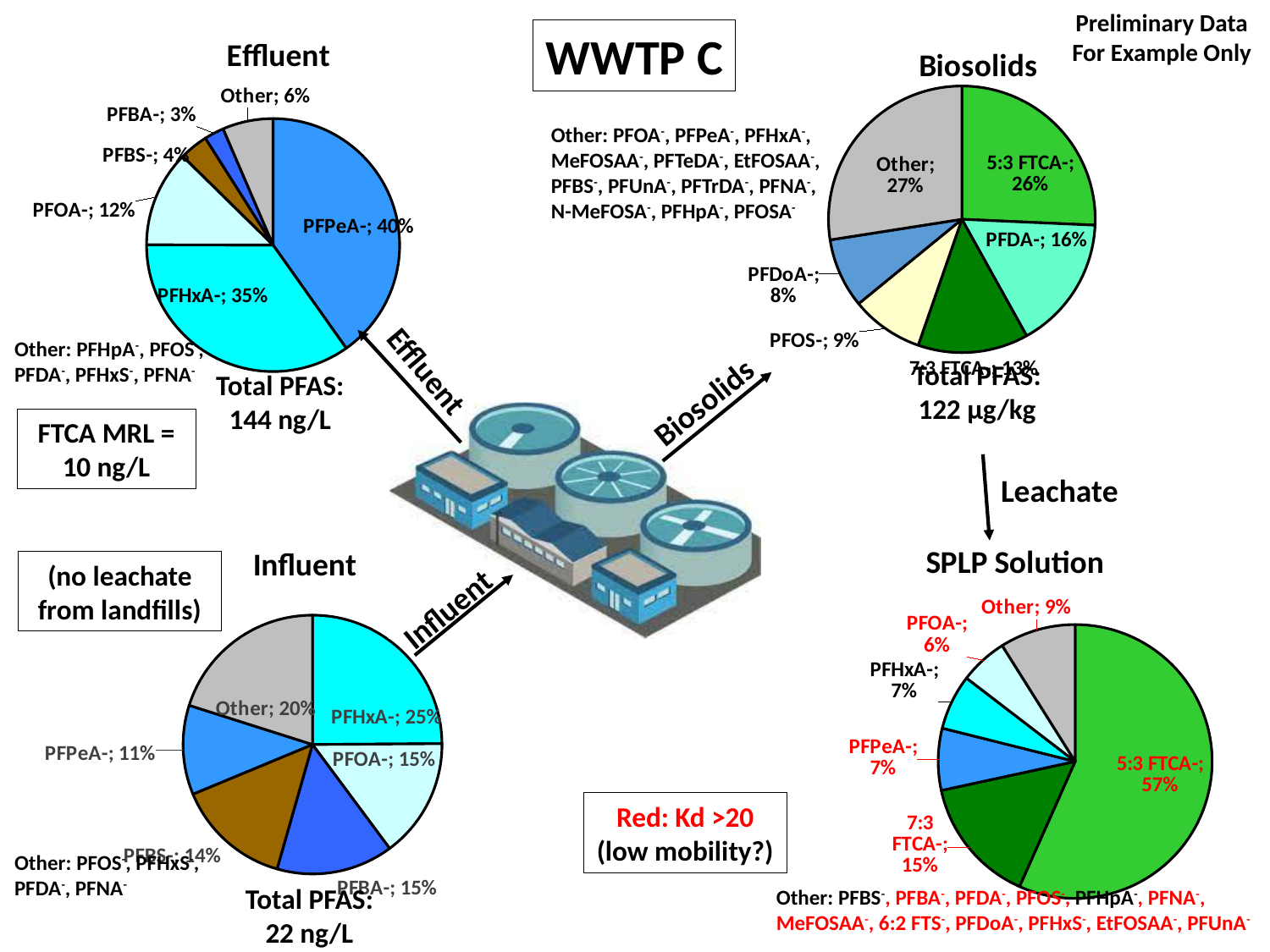
In the SPLP Solution pie chart, what share does 5:3 FTCA- have? 57% In the SPLP Solution pie chart, what is the difference in percentage points between 5:3 FTCA- and 7:3 FTCA-? 42 In the Effluent pie chart, what share does PFPeA- have? 40% In the Influent pie chart, what share does PFHxA- have? 25% In the Effluent pie chart, which category has the smallest share? PFBA- In the Biosolids pie chart, what share does 5:3 FTCA- have? 26% In the Influent pie chart, which is larger, PFOA- or PFPeA-? PFOA- In the Effluent pie chart, which category has the largest share? PFPeA- What kind of chart is used for the Effluent data? Pie chart In the Biosolids pie chart, which is larger, PFDA- or PFOS-? PFDA- In the Effluent pie chart, what is the difference in percentage points between PFHxA- and PFOA-? 23 In the Biosolids pie chart, what share does PFDoA- have? 8%